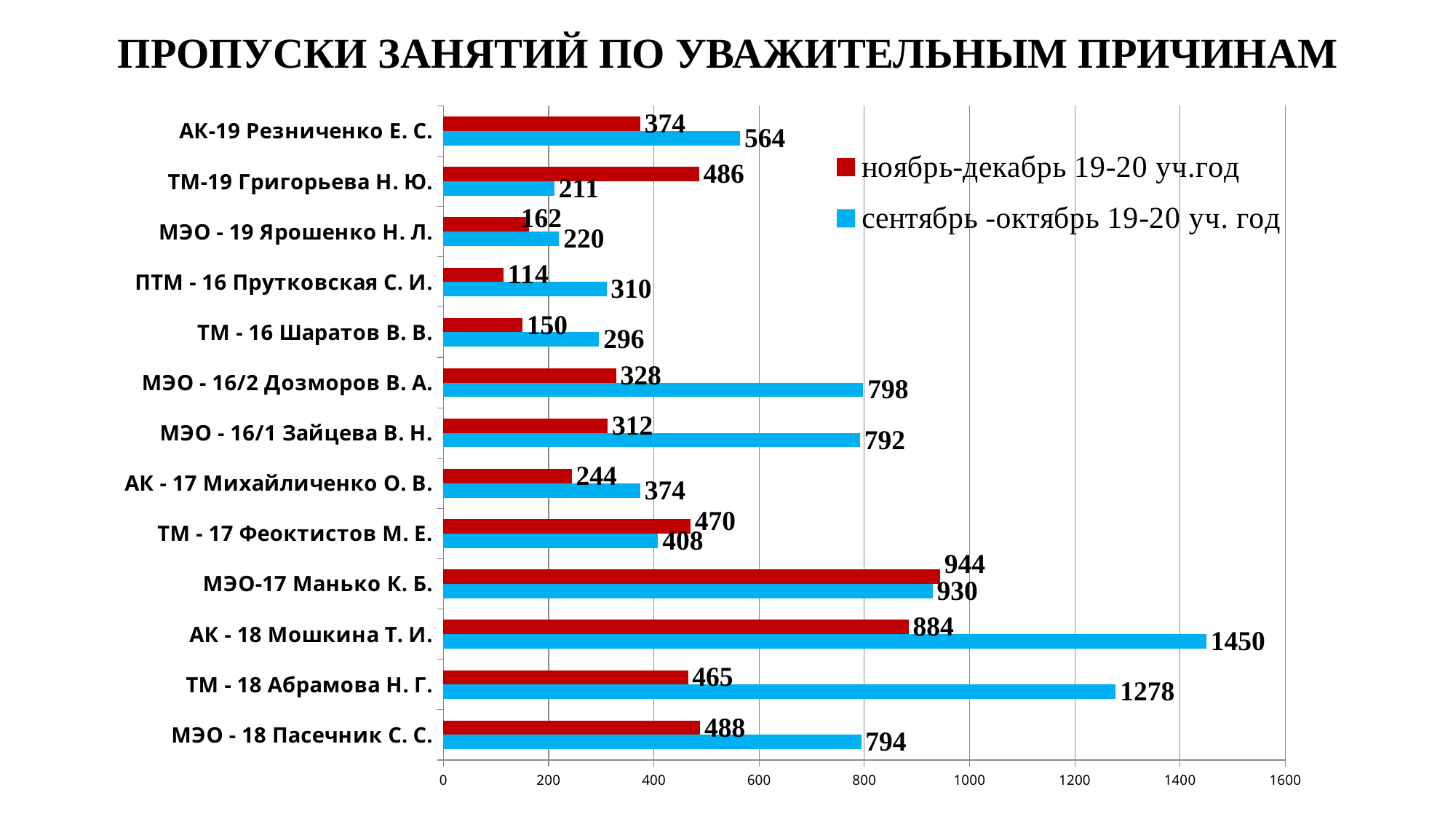
What is the title of the chart? ПРОПУСКИ ЗАНЯТИЙ ПО УВАЖИТЕЛЬНЫМ ПРИЧИНАМ What type of chart is shown on the slide? bar chart How many groups (categories) are shown on the chart? 13 What is the difference between the сентябрь -октябрь and ноябрь-декабрь values for ТМ - 18 Абрамова Н. Г.? 813 Which group has the lowest value in the ноябрь-декабрь 19-20 уч.год series? ПТМ - 16 Прутковская С. И. How many series does the legend list? 2 Which group has the highest value in the сентябрь -октябрь 19-20 уч. год series? АК - 18 Мошкина Т. И. What is the value for МЭО-17 Манько К. Б. in the ноябрь-декабрь 19-20 уч.год series? 944 Which group has the lowest value in the сентябрь -октябрь 19-20 уч. год series? ТМ-19 Григорьева Н. Ю. What is the value for АК - 18 Мошкина Т. И. in the сентябрь -октябрь 19-20 уч. год series? 1450 What is the value for ПТМ - 16 Прутковская С. И. in the сентябрь -октябрь 19-20 уч. год series? 310 For ТМ - 17 Феоктистов М. Е., which series has the larger value: ноябрь-декабрь 19-20 уч.год or сентябрь -октябрь 19-20 уч. год? ноябрь-декабрь 19-20 уч.год